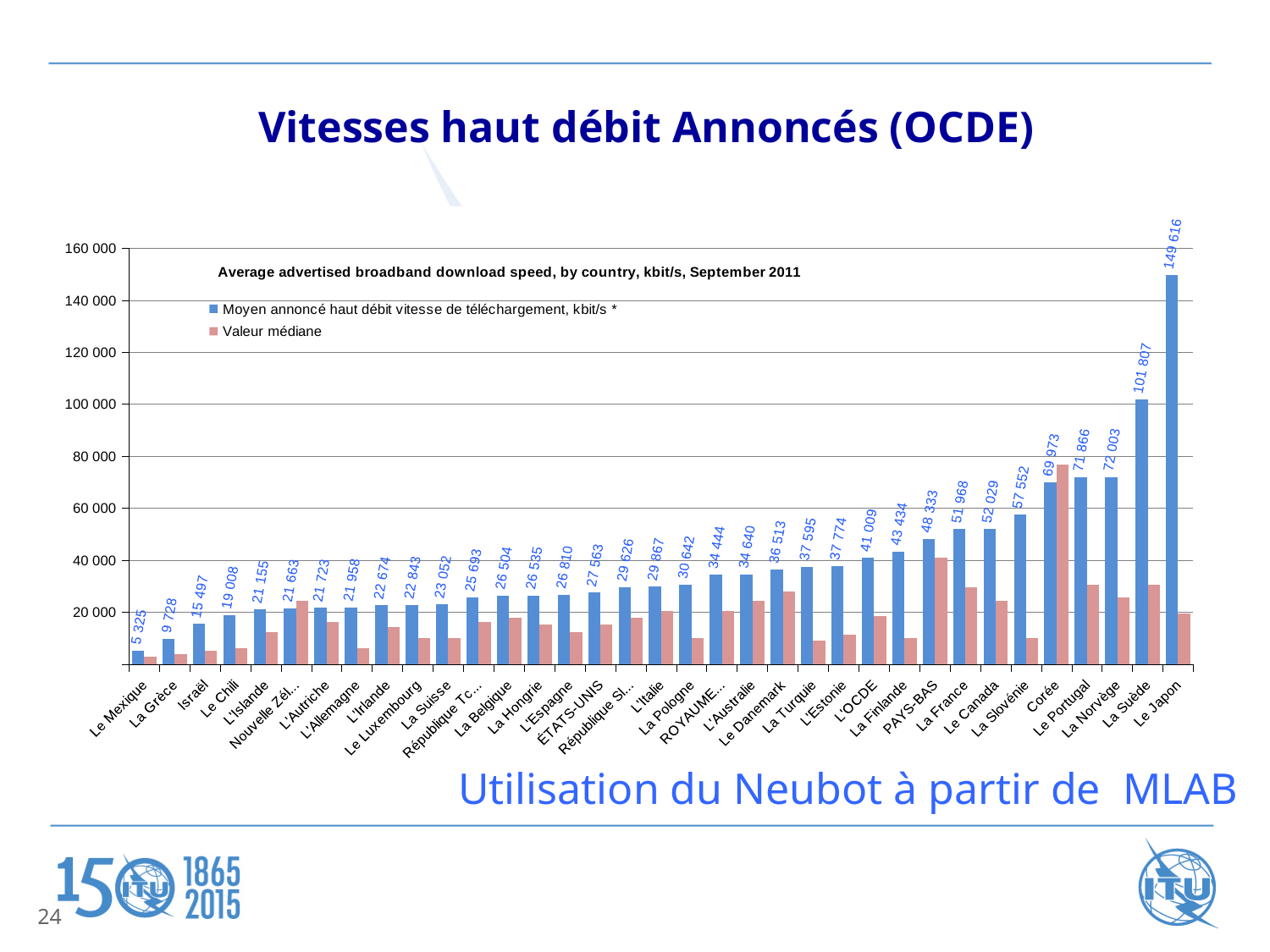
What is the average advertised broadband download speed for Le Japon? 149 616 Which country has the highest average advertised broadband download speed? Le Japon Which country has the lowest average advertised broadband download speed? Le Mexique What is the difference between the average advertised download speeds of Le Japon and La Suède? 47 809 What is the average advertised broadband download speed for Le Mexique? 5 325 How many series does the legend list? 2 What kind of chart is shown on the slide? bar chart What is the average advertised broadband download speed for L'OCDE? 41 009 What is the average advertised broadband download speed for La Suède? 101 807 Is the median value (Valeur médiane) for Corée greater or less than 60 000? greater Do the average advertised download speeds rise or fall from left to right along the x axis? rise Which has a higher average advertised download speed, La France or Le Canada? Le Canada